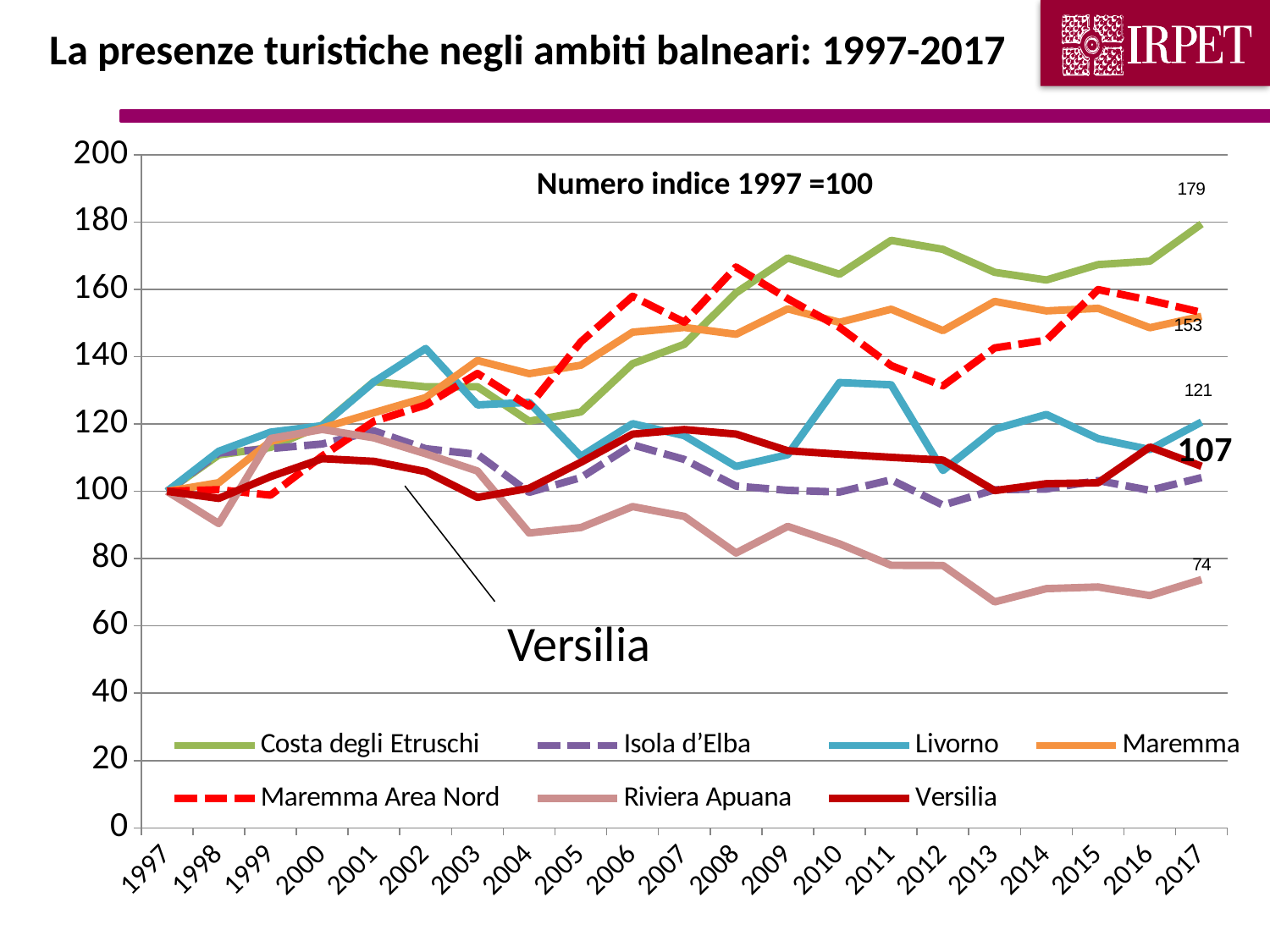
What is the 2017 value for Versilia? 107 How many years are shown along the x axis? 21 What kind of chart is shown on the slide? Line chart Which series has the lowest value in 2017? Riviera Apuana What is the 2017 value for Livorno? 121 What is the 2017 value for Costa degli Etruschi? 179 Is the value for Riviera Apuana in 2013 greater or less than 80? less In 2017, which is larger: the value for Livorno or the value for Versilia? Livorno What is the difference between the 2017 values of Costa degli Etruschi and Riviera Apuana? 105 Which series has the highest value in 2017? Costa degli Etruschi What is the 2017 value for Riviera Apuana? 74 How many series does the legend list? 7